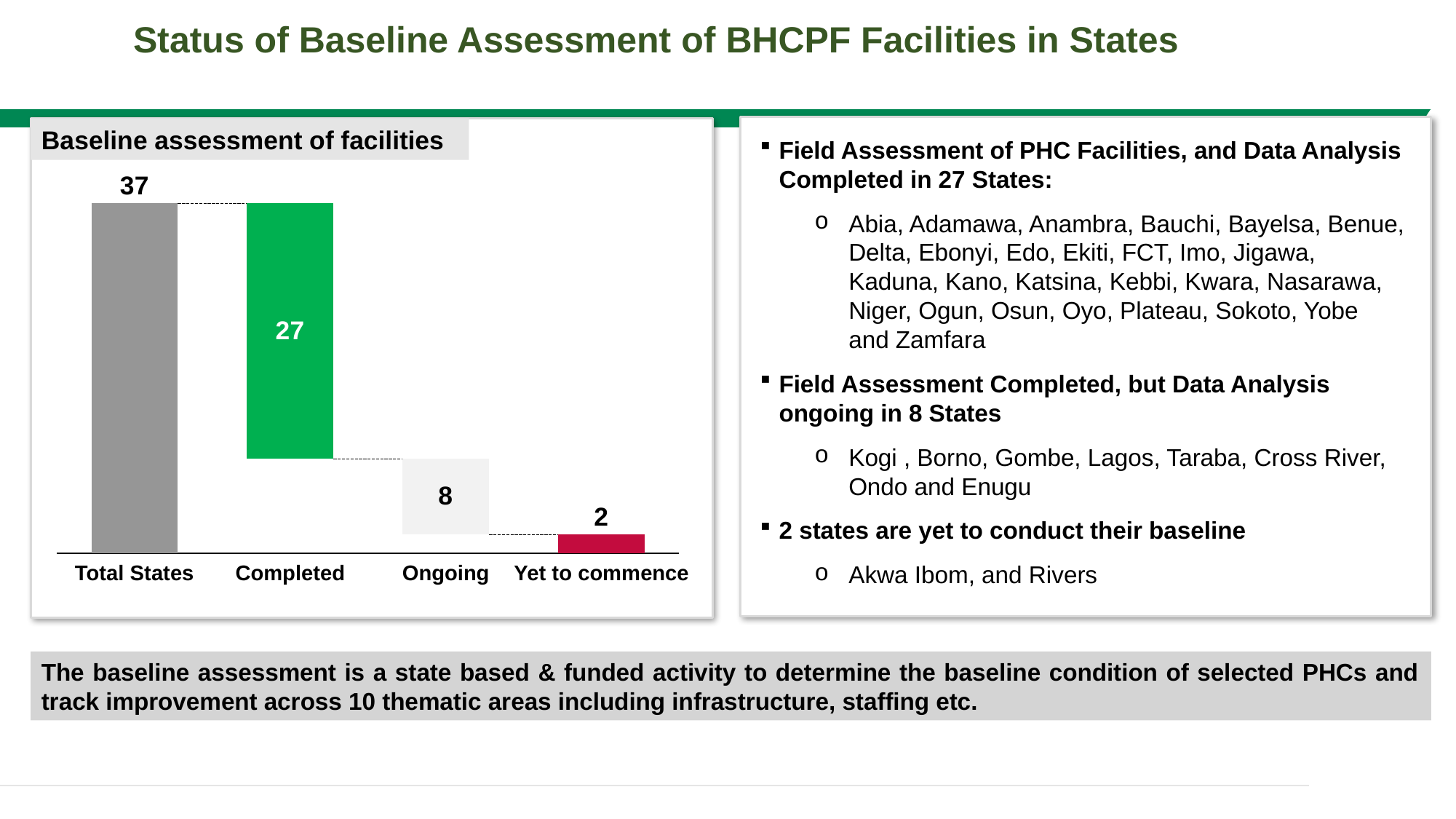
Which is larger in the Baseline assessment of facilities chart, Ongoing or Yet to commence? Ongoing What is the difference between Total States and Completed in the Baseline assessment of facilities chart? 10 What is the value for Completed in the Baseline assessment of facilities chart? 27 Which category has the highest value in the Baseline assessment of facilities chart? Total States What kind of chart is the Baseline assessment of facilities chart? Bar chart What is the value for Ongoing in the Baseline assessment of facilities chart? 8 Which category has the lowest value in the Baseline assessment of facilities chart? Yet to commence What colour is the Completed bar in the Baseline assessment of facilities chart? Green What is the value for Total States in the Baseline assessment of facilities chart? 37 How many categories are shown on the x axis of the Baseline assessment of facilities chart? 4 What is the difference between the Completed and Ongoing values in the Baseline assessment of facilities chart? 19 What is the value for Yet to commence in the Baseline assessment of facilities chart? 2